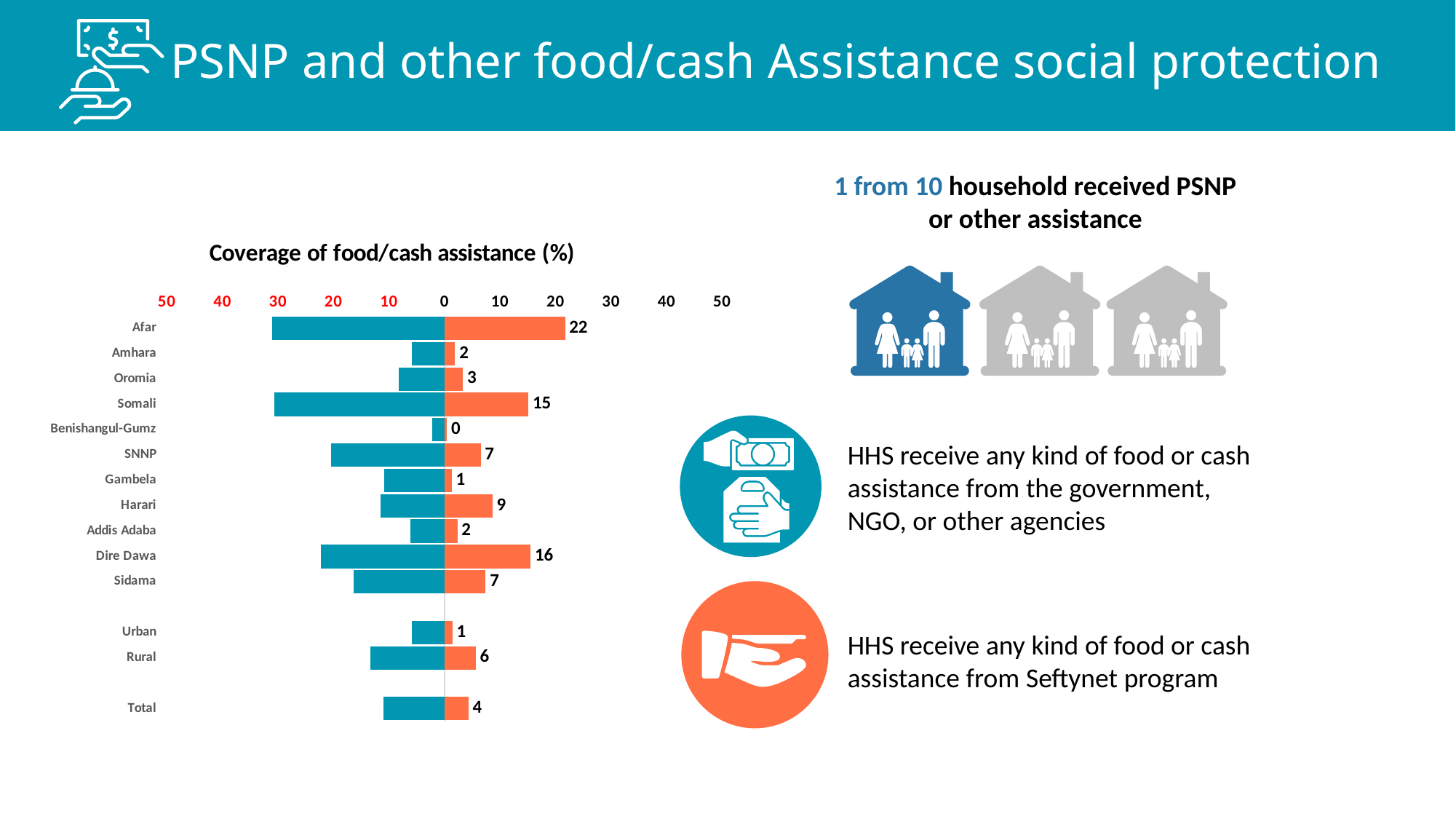
Which region has the highest orange (Safety net program) value? Afar Is the teal (any food/cash assistance) value for Afar greater or less than 20? greater Which has a larger orange (Safety net program) value, Rural or Urban? Rural What is the orange (Safety net program) value for Afar in the coverage chart? 22 What is the orange (Safety net program) value for Total? 4 What is the title of the chart on the slide? Coverage of food/cash assistance (%) Is the teal (any food/cash assistance) value for Amhara greater or less than 10? less What is the orange (Safety net program) value for Somali? 15 What is the difference between the orange values for Afar and Somali? 7 What type of chart is used to show the coverage of food/cash assistance? Bar chart Which region has the lowest orange (Safety net program) value? Benishangul-Gumz What is the orange (Safety net program) value for Dire Dawa? 16